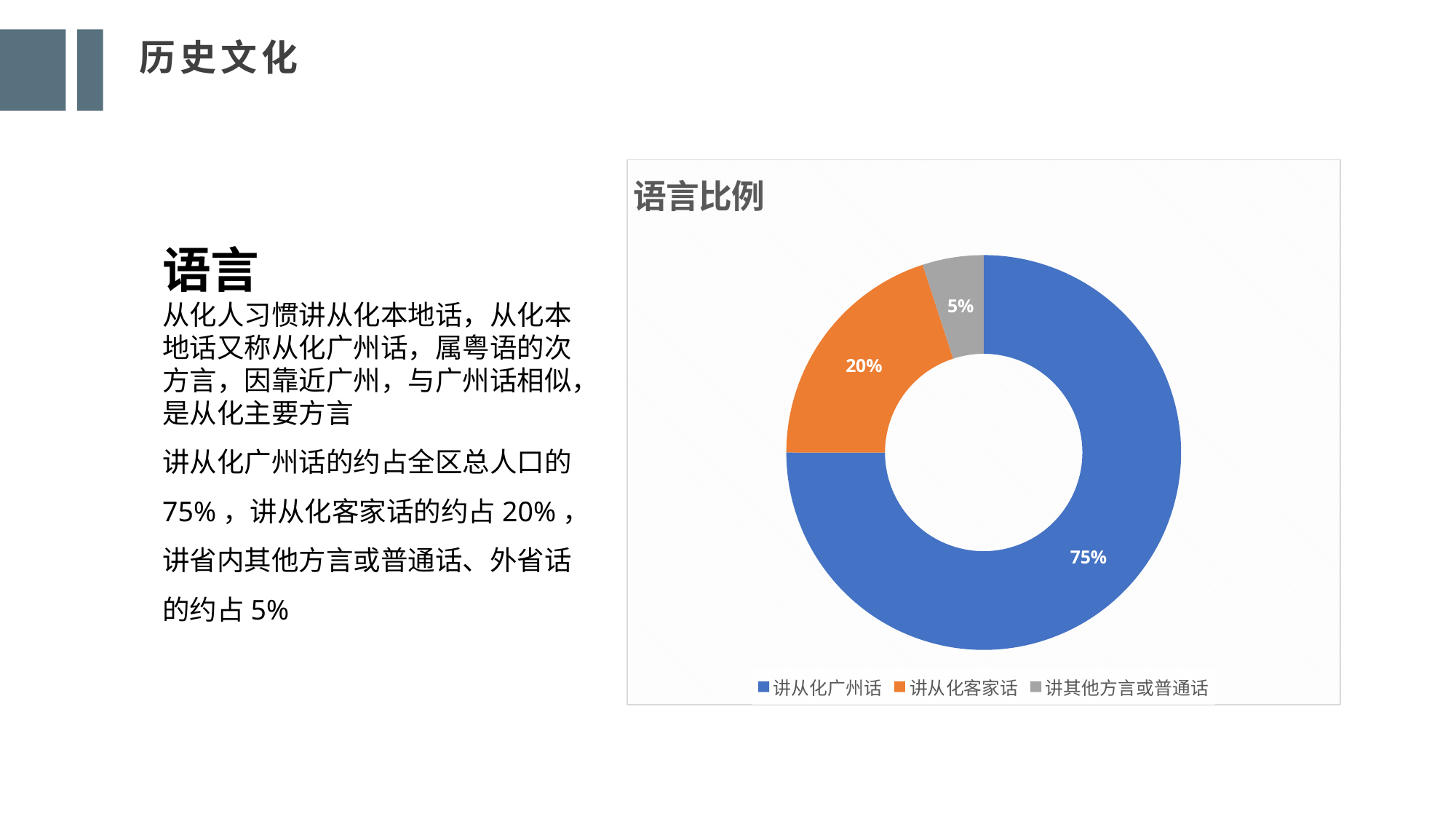
What is the title of the chart? 语言比例 What kind of chart is shown on the slide? doughnut chart Which is larger, the share for 讲从化客家话 or the share for 讲其他方言或普通话? 讲从化客家话 What is the difference in percentage points between 讲从化客家话 and 讲其他方言或普通话? 15 What percentage of the chart is 讲从化广州话? 75% What colour is the slice for 讲从化客家话? orange What is the difference in percentage points between 讲从化广州话 and 讲从化客家话? 55 What percentage of the chart is 讲其他方言或普通话? 5% What percentage of the chart is 讲从化客家话? 20% Which category has the largest share in the chart? 讲从化广州话 How many categories does the chart show? 3 Which category has the smallest share in the chart? 讲其他方言或普通话